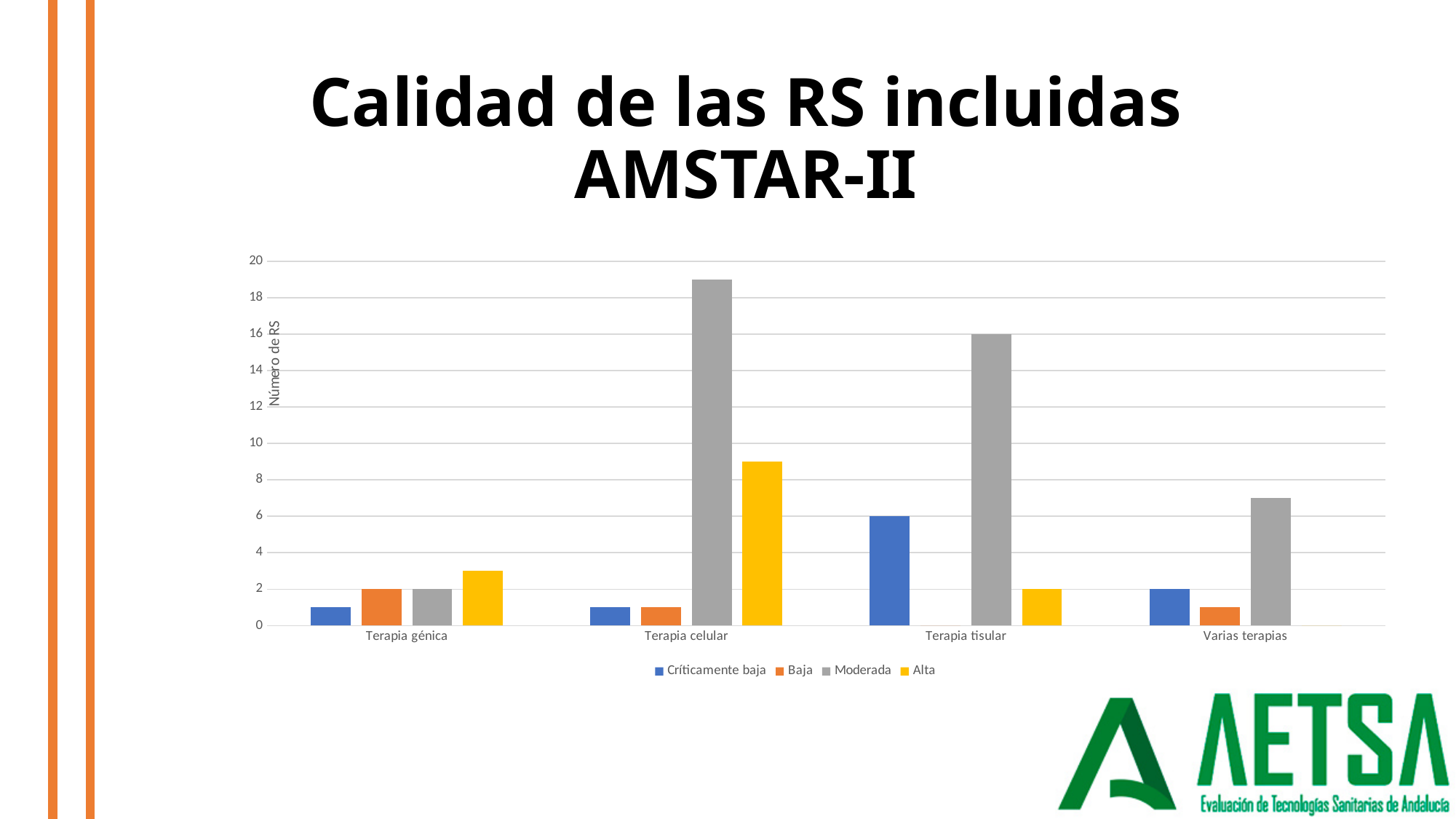
What is the value of Moderada for Terapia tisular? 16 What is the value of Alta for Terapia tisular? 2 What is the value of Críticamente baja for Varias terapias? 2 What is the value of Críticamente baja for Terapia tisular? 6 How many categories are shown on the x axis? 4 Which category has the highest Moderada value? Terapia celular Which is larger, the Moderada value for Terapia celular or for Terapia tisular? Terapia celular What is the difference between the Moderada and Críticamente baja values for Terapia tisular? 10 Is the Alta value for Terapia celular greater or less than 10? less How many series does the legend list? 4 Is the Moderada value for Terapia celular greater or less than 18? greater What kind of chart is shown on the slide? bar chart